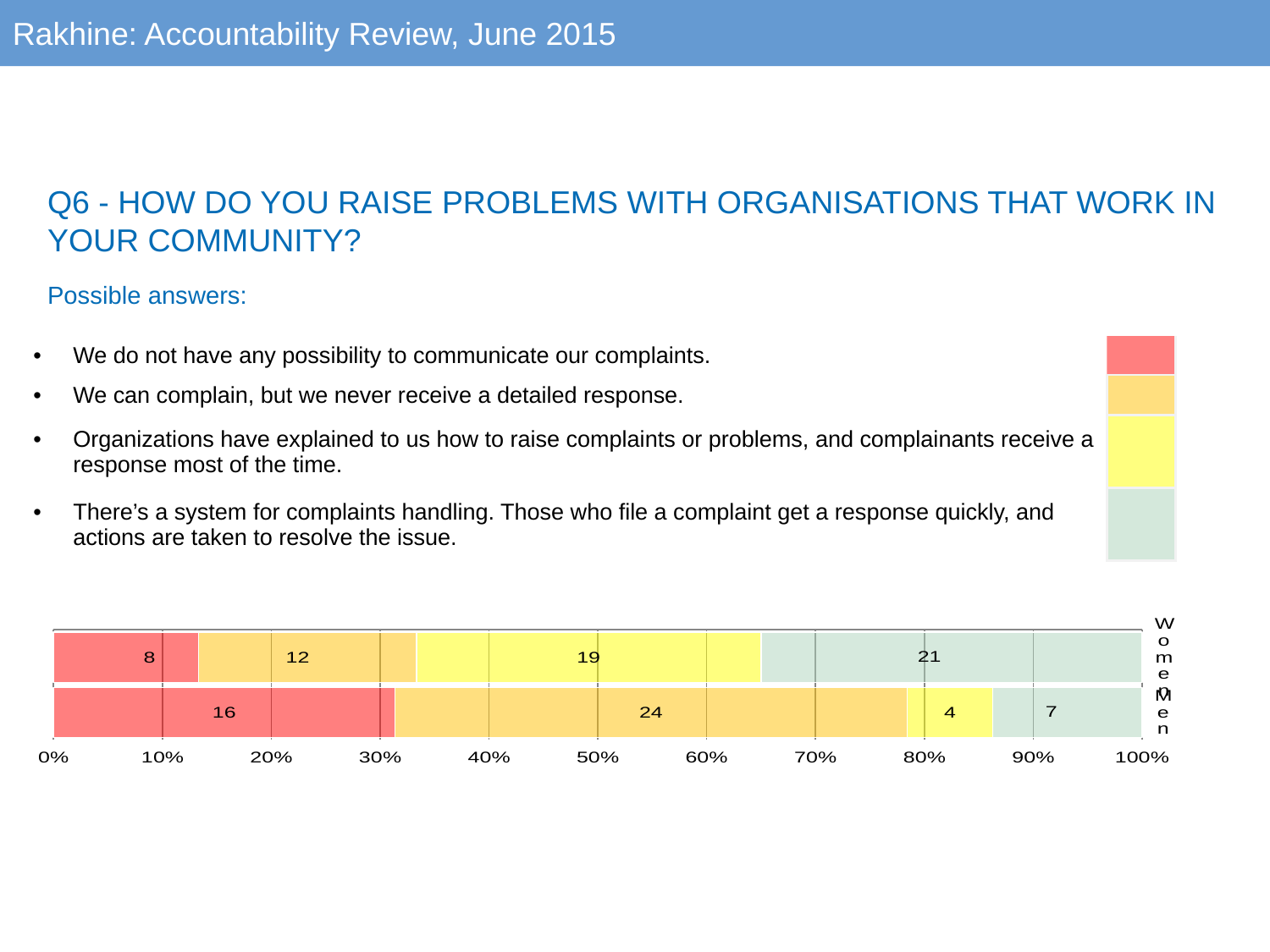
What is the value of the red segment for Women? 8 How many categories (bars) does the chart show? 2 What is the value of the green segment for Men? 7 What is the value of the yellow segment for Women? 19 What is the total of all segments in the Men bar? 51 What is the total of all segments in the Women bar? 60 Which segment has the largest value in the Men bar? The orange segment (24) What kind of chart is shown on the slide? Stacked bar chart Which segment has the smallest value in the Women bar? The red segment (8) Which is larger: the green segment for Women or the green segment for Men? Women What is the value of the orange segment for Men? 24 What is the difference between the red segment for Men and the red segment for Women? 8